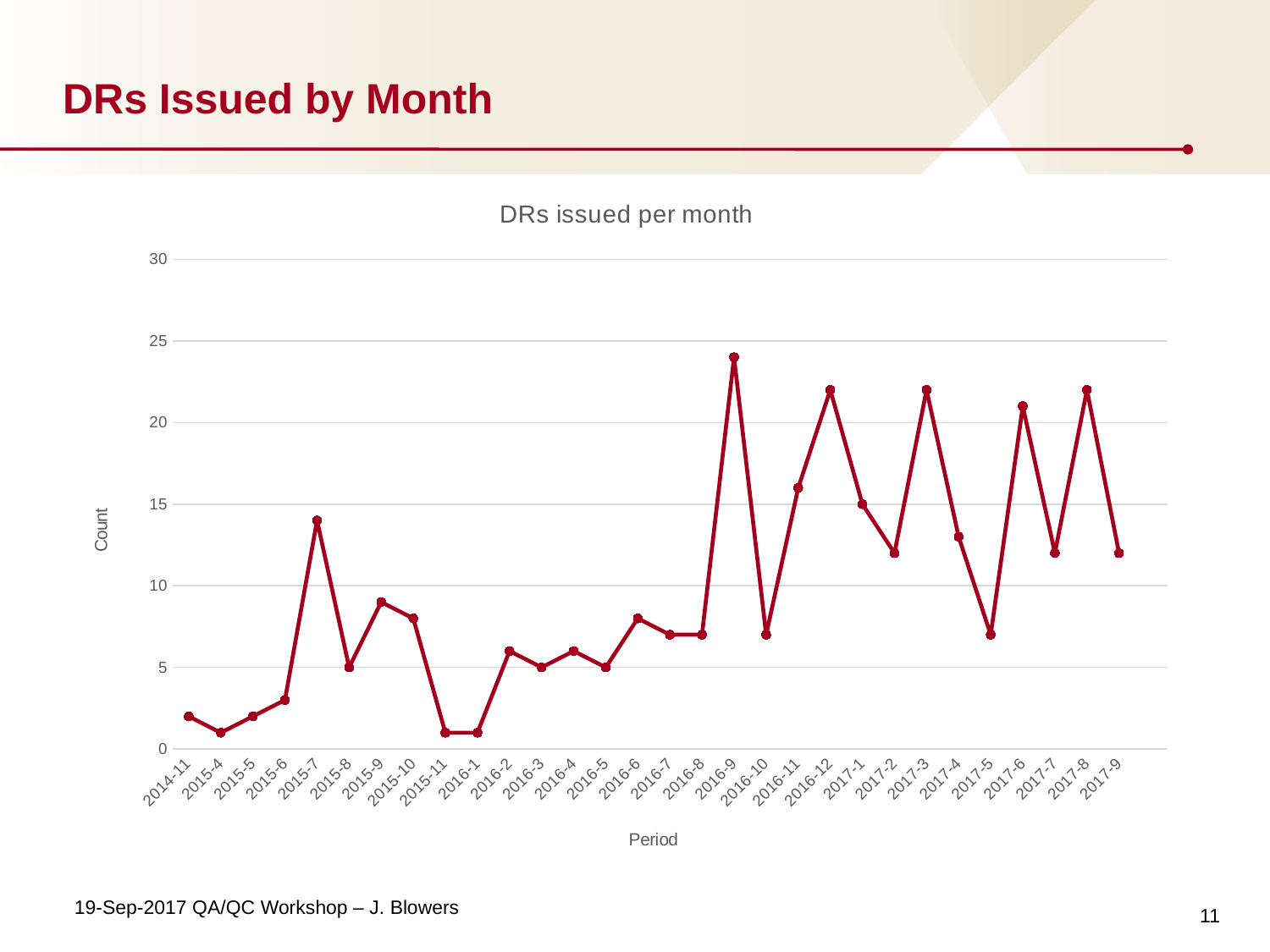
What type of chart is shown on the slide? Line chart What is the count for 2017-1? 15 What is the title of the chart? DRs issued per month Which period has the highest count of DRs issued? 2016-9 Which has a higher count, 2015-7 or 2016-9? 2016-9 Is the value for 2016-9 greater or less than 20? greater Is the value for 2017-5 greater or less than 10? less Is the value for 2015-7 greater or less than 15? less Which has a higher count, 2017-5 or 2017-6? 2017-6 What is the label of the vertical axis? Count How many periods are plotted along the x axis? 30 What is the count for 2015-8? 5